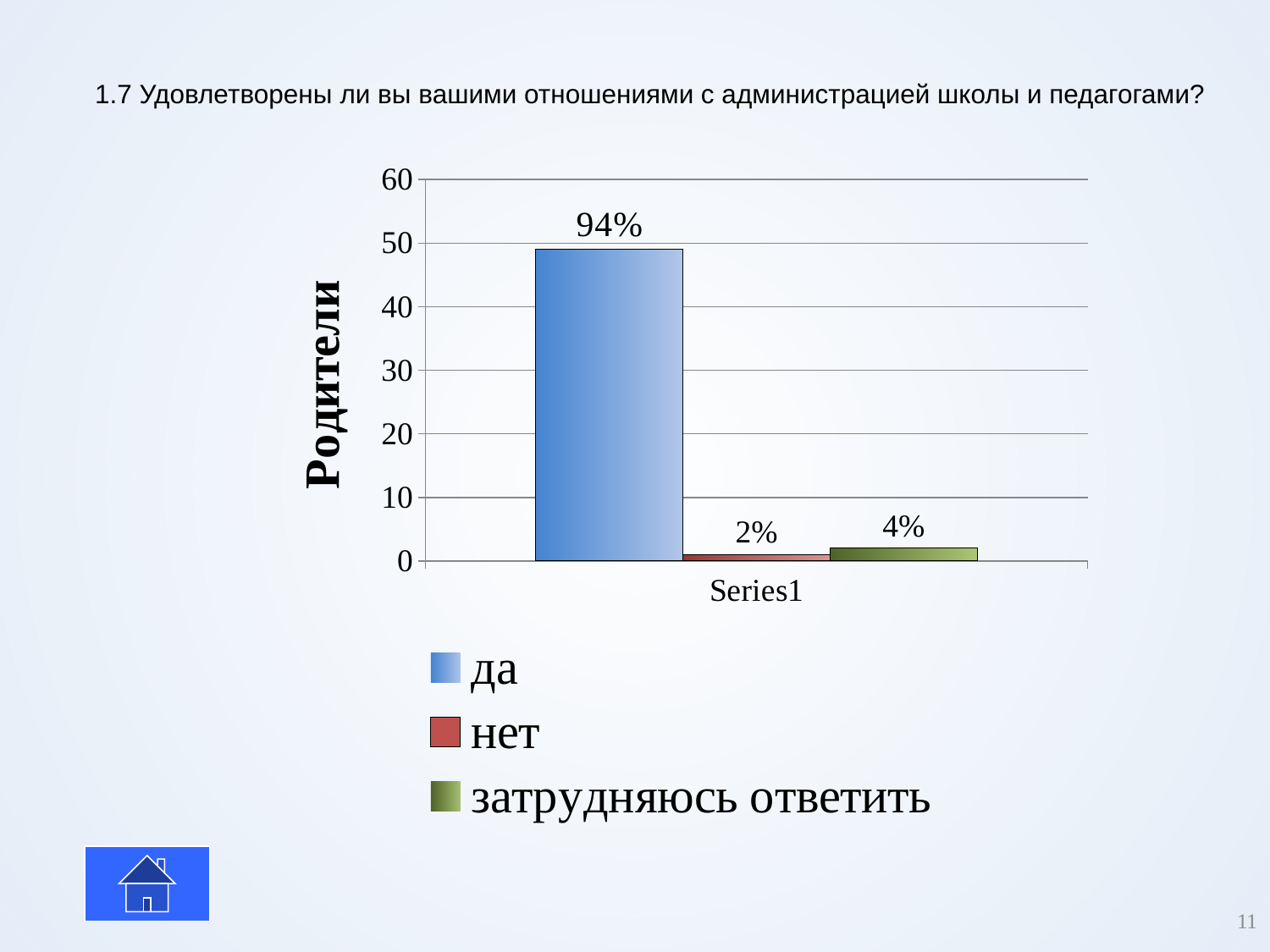
What is the difference between the data labels for "да" and "нет"? 92% Is the bar for "затрудняюсь ответить" greater or less than 10 on the vertical axis? less How many series does the legend list? 3 What is the title of the vertical axis? Родители What data label is shown on the bar for "да"? 94% What kind of chart is shown on the slide? bar chart Which is larger, the bar for "нет" or the bar for "затрудняюсь ответить"? затрудняюсь ответить Which legend entry has the highest bar? да Which legend entry has the lowest bar? нет What data label is shown on the bar for "нет"? 2% Is the bar for "да" greater or less than 40 on the vertical axis? greater What data label is shown on the bar for "затрудняюсь ответить"? 4%